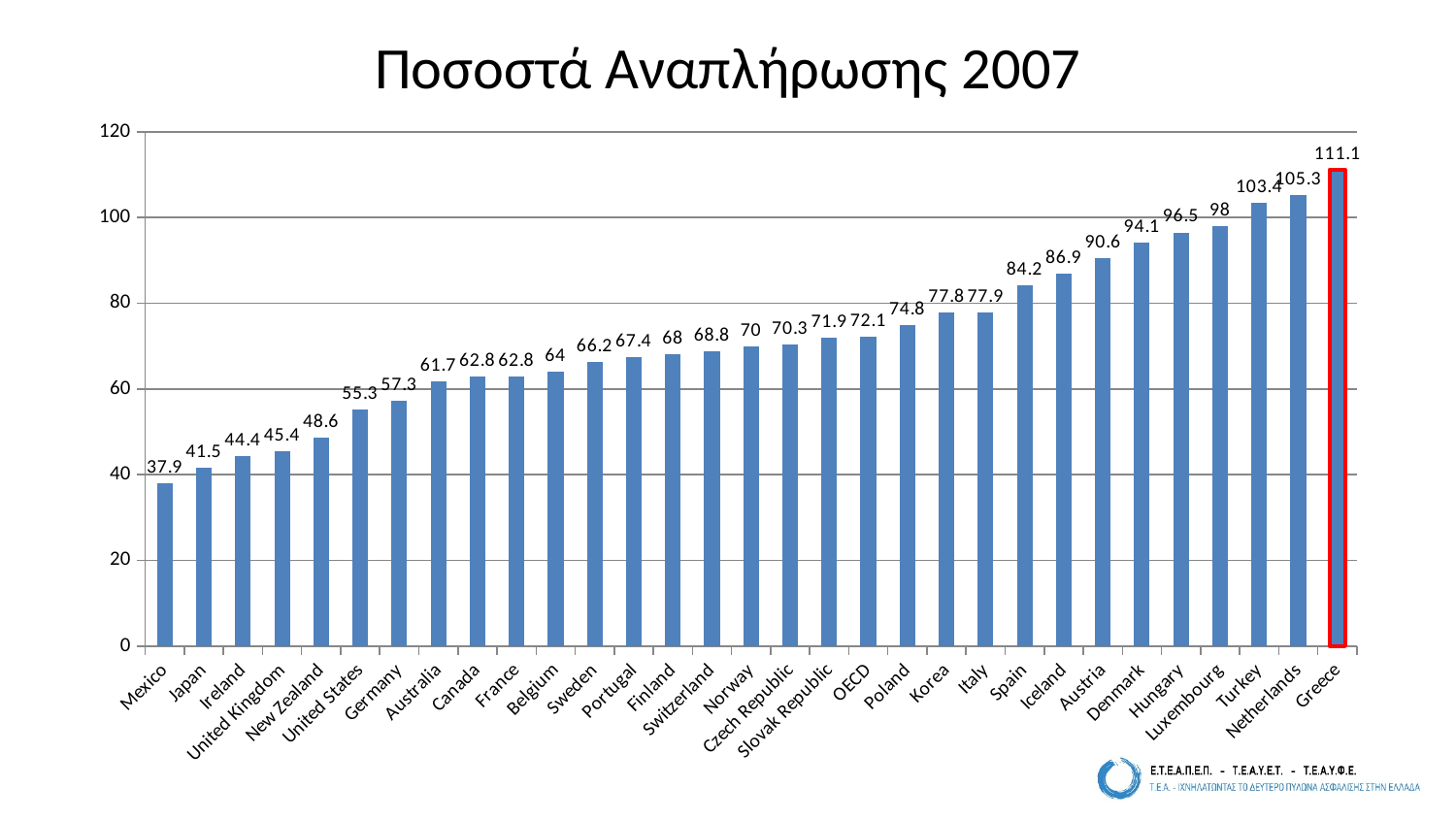
Do the values rise or fall from left to right along the x axis? Rise What is the value for Luxembourg? 98 What is the difference between the values for Greece and Mexico? 73.2 What is the value for OECD? 72.1 What is the difference between the values for Netherlands and Turkey? 1.9 How many countries/categories are shown on the x axis? 31 Which country has the highest value? Greece What kind of chart is shown on the slide? Bar chart What is the value for Greece? 111.1 Which is larger, the value for Spain or the value for Poland? Spain What is the value for Germany? 57.3 Which country has the lowest value? Mexico